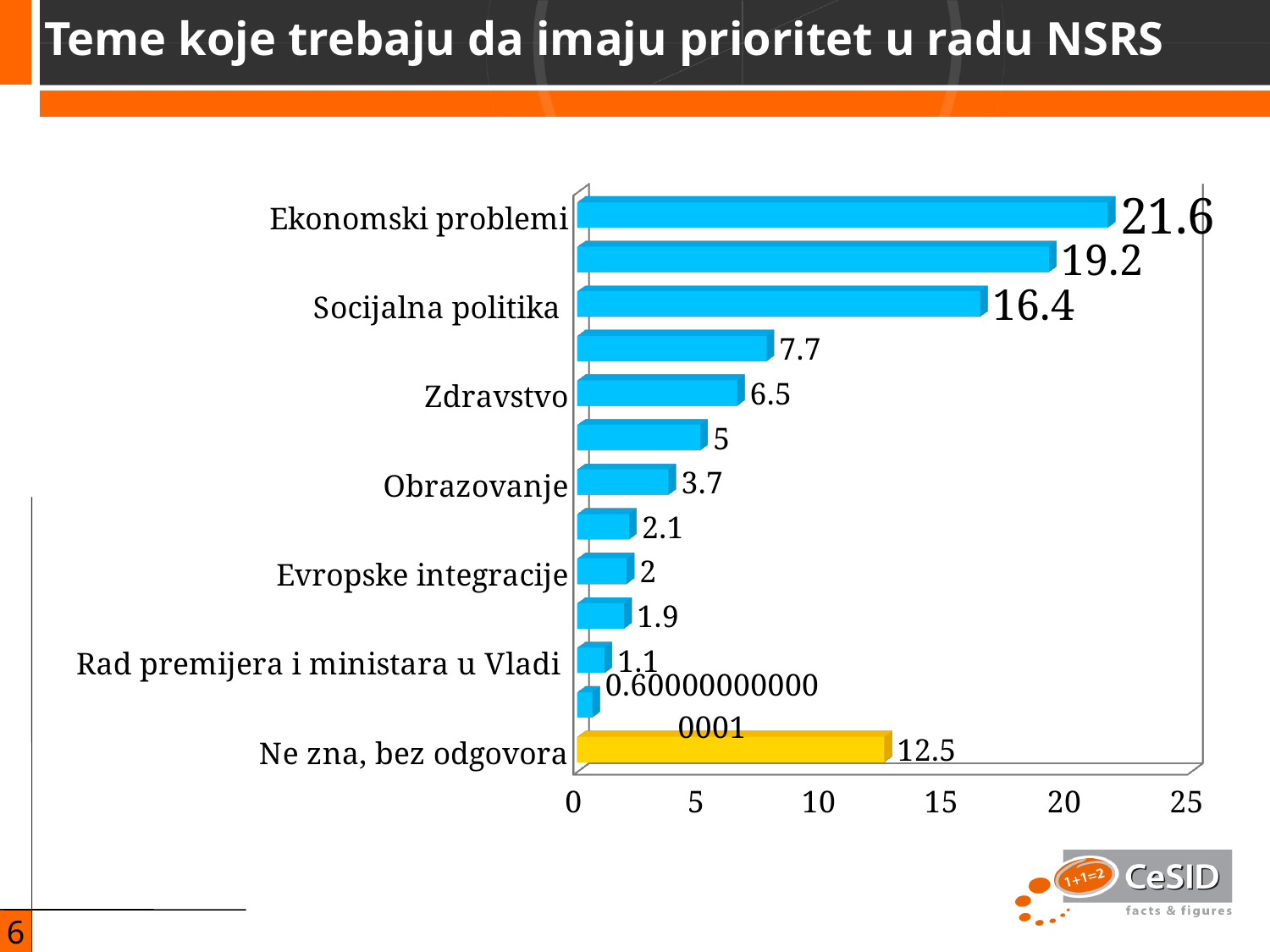
What value is shown for Socijalna politika? 16.4 What value is shown for Ne zna, bez odgovora? 12.5 What value is shown for Zdravstvo? 6.5 Which labeled category has the highest value? Ekonomski problemi What value is shown for Obrazovanje? 3.7 What is the difference between the values for Ekonomski problemi and Socijalna politika? 5.2 Which is larger, the value for Zdravstvo or the value for Ne zna, bez odgovora? Ne zna, bez odgovora What kind of chart is shown on the slide? bar chart Is the value for Socijalna politika greater or less than 15? greater What value is shown for Rad premijera i ministara u Vladi? 1.1 What value is shown for Ekonomski problemi? 21.6 How many bars are plotted in the chart? 13